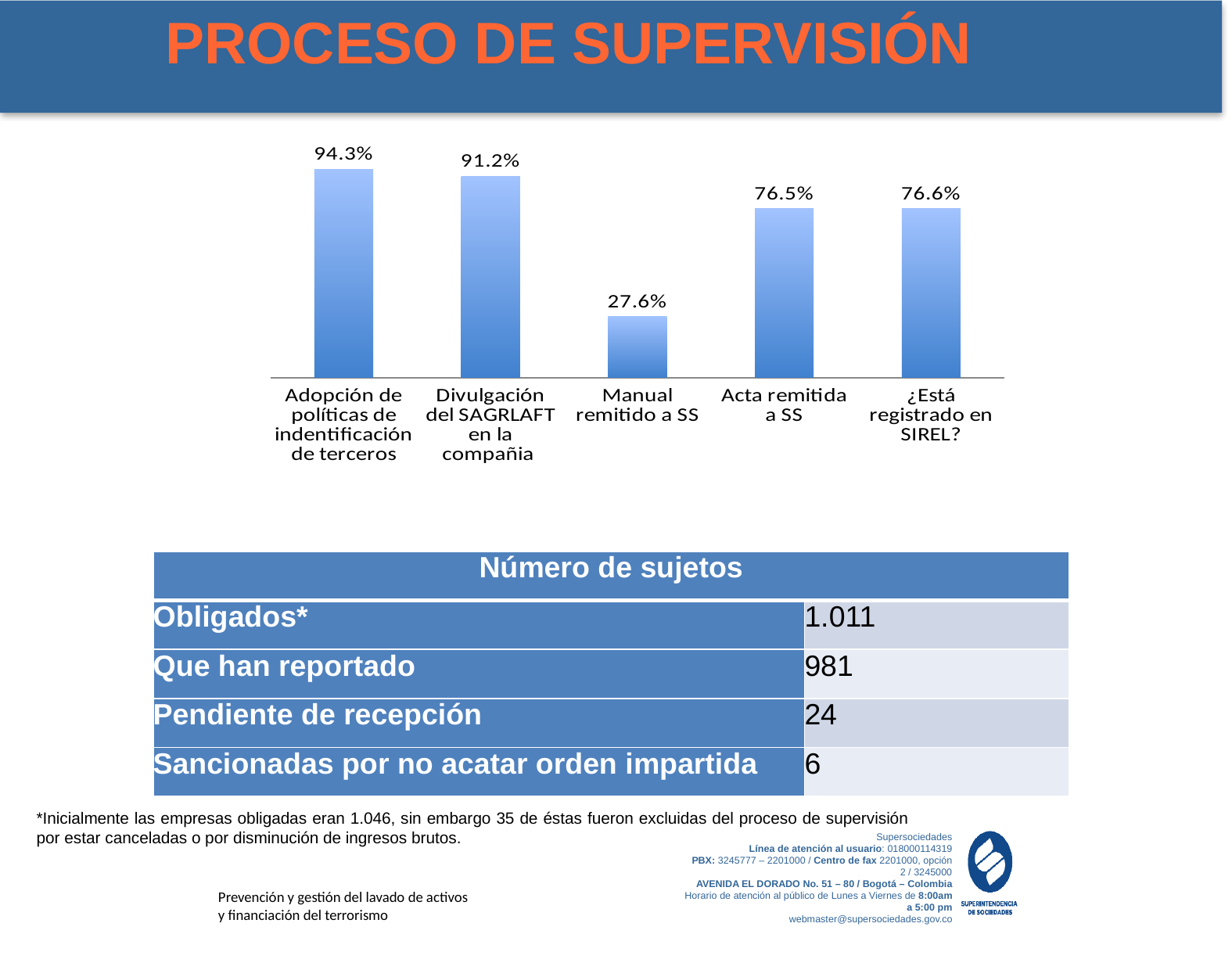
Which category has the highest value? Adopción de políticas de indentificación de terceros What is the difference between the values for '¿Está registrado en SIREL?' and 'Acta remitida a SS'? 0.1% What type of chart is shown on the slide? bar chart What is the value for 'Manual remitido a SS'? 27.6% What is the value for 'Adopción de políticas de indentificación de terceros'? 94.3% Which is larger, the value for 'Divulgación del SAGRLAFT en la compañia' or the value for 'Acta remitida a SS'? Divulgación del SAGRLAFT en la compañia What is the value for 'Divulgación del SAGRLAFT en la compañia'? 91.2% What is the difference between the values for 'Adopción de políticas de indentificación de terceros' and 'Manual remitido a SS'? 66.7% Which category has the lowest value? Manual remitido a SS What is the value for 'Acta remitida a SS'? 76.5% What is the value for '¿Está registrado en SIREL?'? 76.6% How many categories does the bar chart show? 5